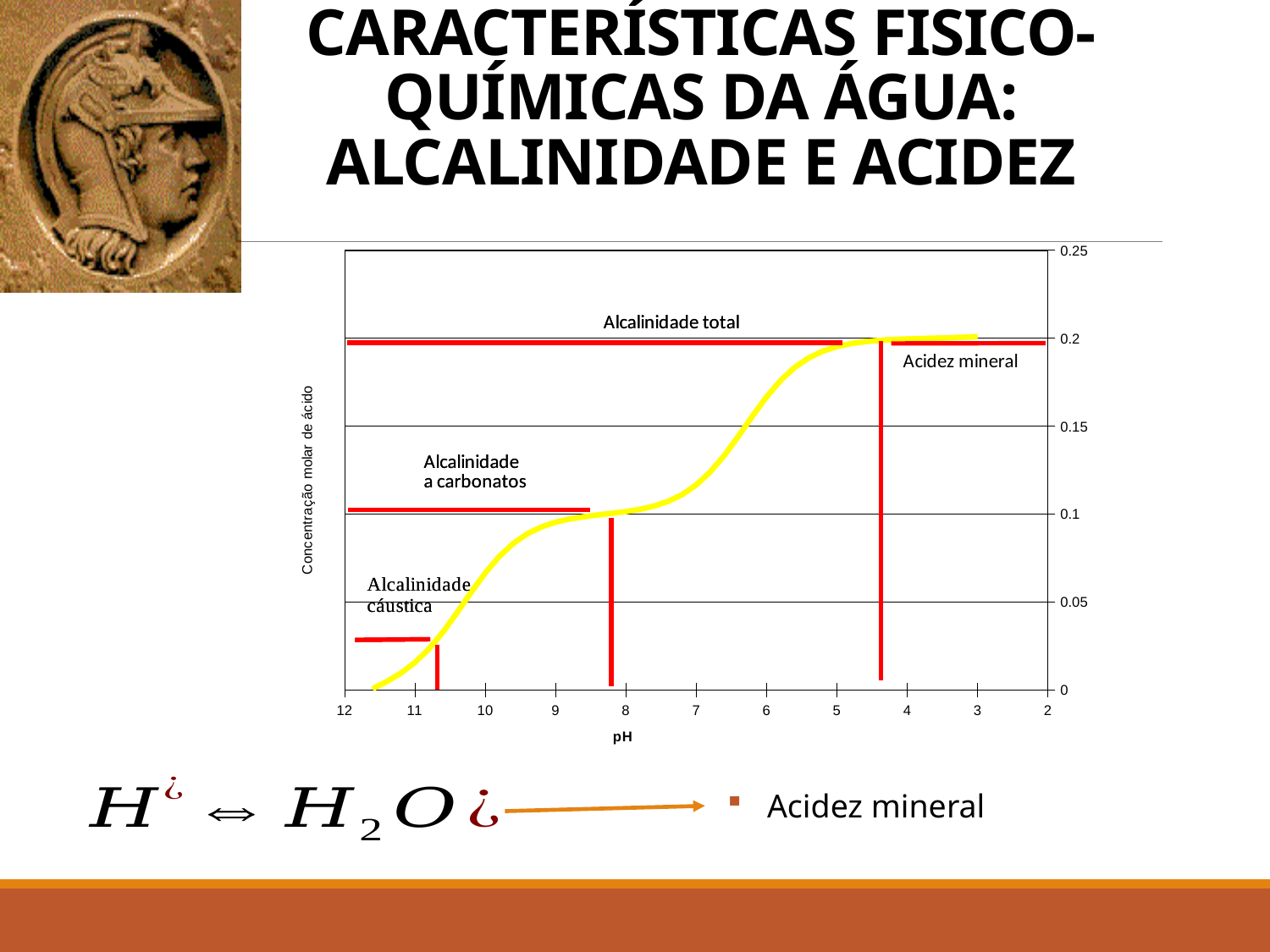
Does the plotted curve rise or fall from left to right along the pH axis? rise Is the value of the curve at pH 10 greater or less than 0.1? less What is the label of the vertical axis of the chart? Concentração molar de ácido How many tick labels are shown on the pH axis? 11 Is the value of the curve at pH 9 greater or less than 0.05? greater Is the value of the curve at pH 4 greater or less than 0.15? greater What kind of chart is shown on the slide? line chart What label is written above the long red horizontal line at the 0.2 level on the chart? Alcalinidade total